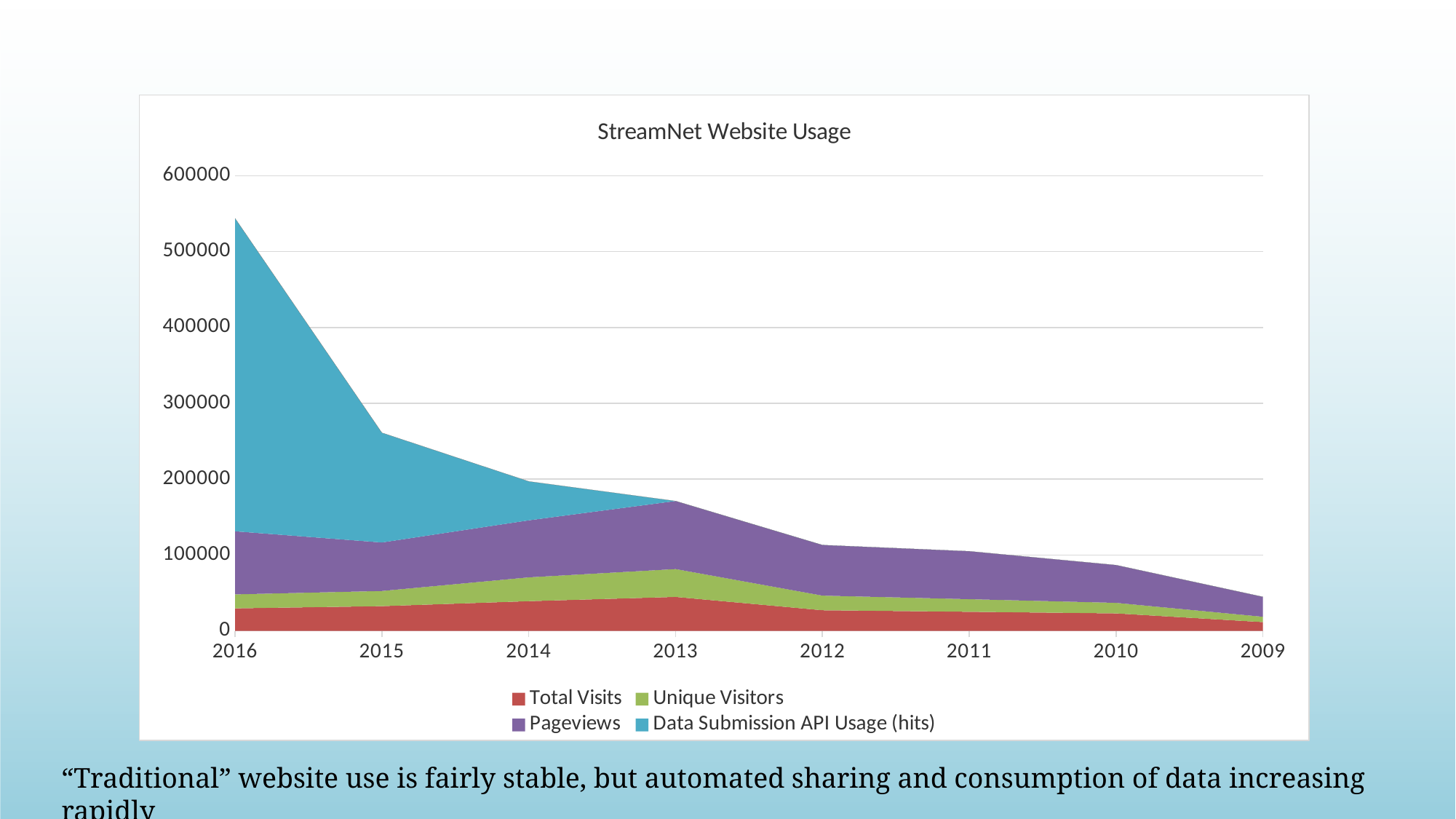
How many years are shown along the x axis? 8 What type of chart is shown on the slide? Stacked area chart What is the title of the chart? StreamNet Website Usage Is the total stacked value for 2016 larger or smaller than the total for 2015? larger Is the total stacked value for 2015 greater or less than 300000? less Is the total stacked value for 2016 greater or less than 500000? greater Do the total stacked values rise or fall moving from left (2016) to right (2009) along the x axis? fall How many series does the legend list? 4 Which series is shown in blue (cyan) in the chart? Data Submission API Usage (hits) Is the total stacked value for 2009 greater or less than 100000? less Which year has the lowest total stacked value? 2009 Which year has the highest total stacked value? 2016